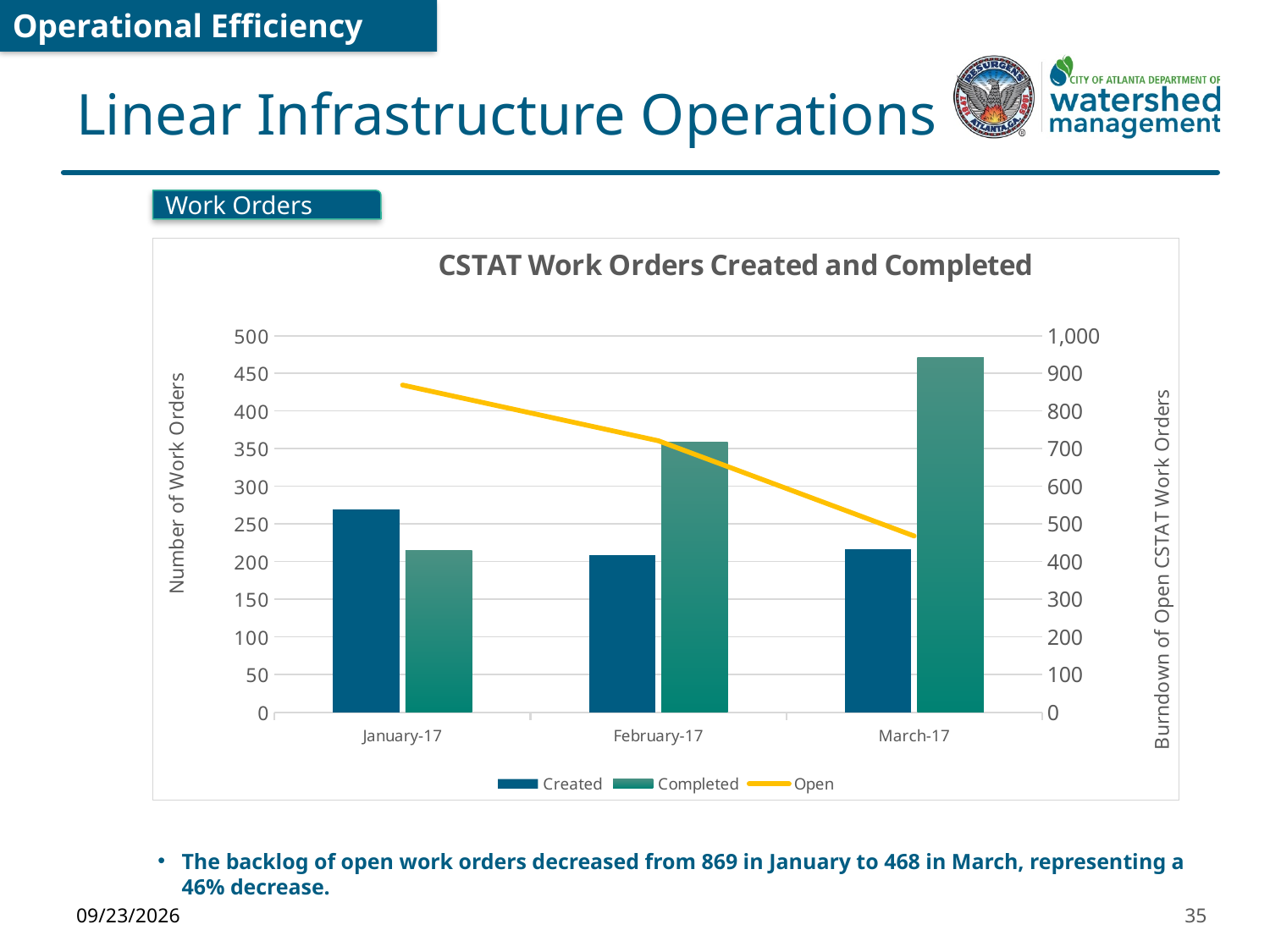
In February-17, which is larger, Created or Completed? Completed How many series does the chart legend list? 3 Is the Completed value for March-17 greater or less than 450? greater How many months are shown on the x axis of the chart? 3 By how much did the number of open work orders decrease from January to March? 401 What was the number of open work orders in March-17 according to the slide? 468 What was the number of open work orders in January-17 according to the slide? 869 In which month is the Completed bar highest? March-17 In which month is the Created bar highest? January-17 What is the title of the chart? CSTAT Work Orders Created and Completed Does the Open line rise or fall from January-17 to March-17? fall What kind of chart is used to show the Created and Completed series? bar chart